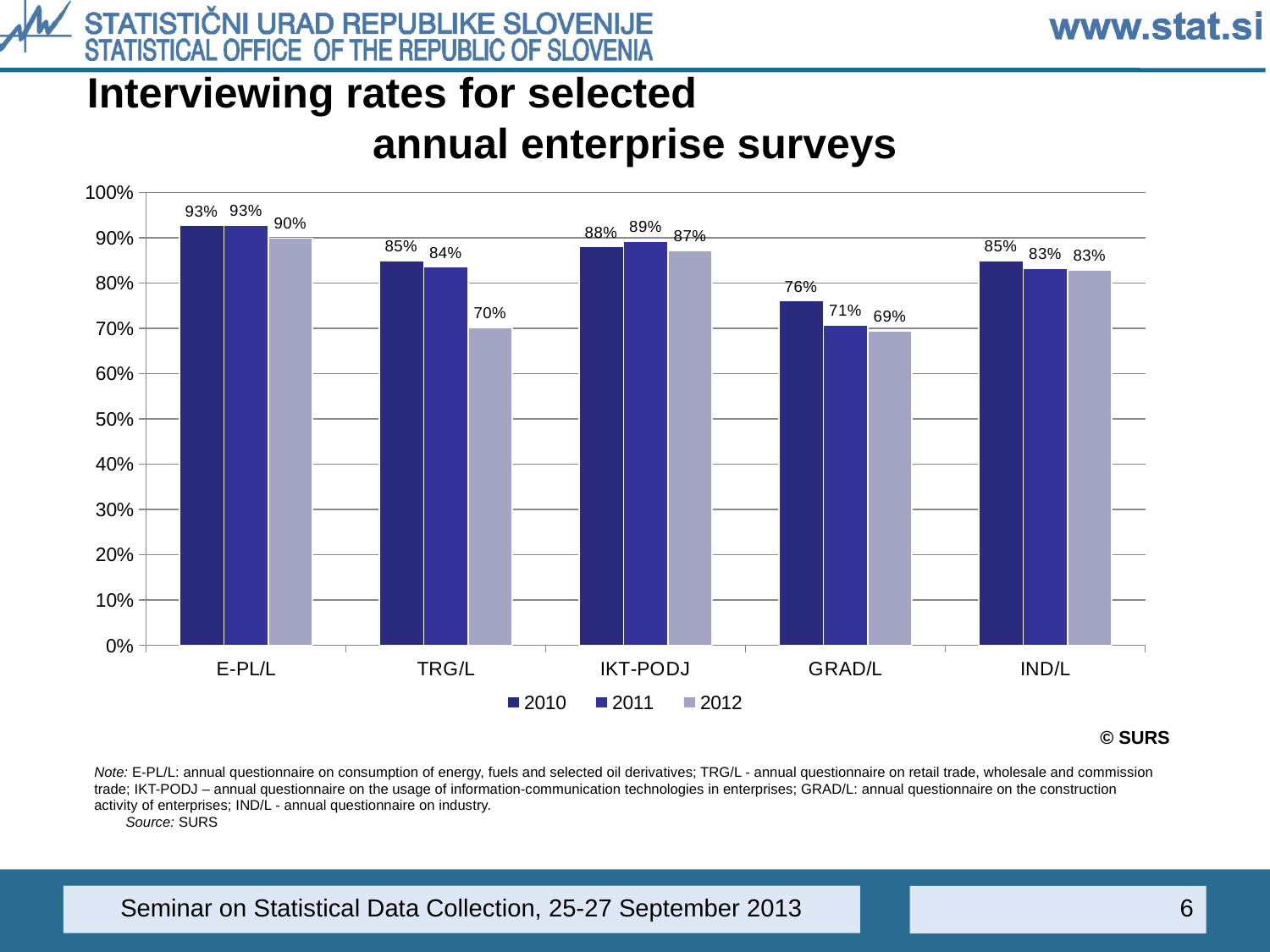
Which survey has the lowest interviewing rate in 2012? GRAD/L What is the difference between the 2010 and 2012 interviewing rates for TRG/L? 15% What is the interviewing rate for GRAD/L in 2010? 76% How many series does the legend list? 3 What is the interviewing rate for IKT-PODJ in 2011? 89% What kind of chart is shown on the slide? Bar chart Which years are listed in the chart legend? 2010, 2011, 2012 Do the interviewing rates for GRAD/L rise or fall from 2010 to 2012? Fall How many surveys are shown on the x axis? 5 What is the interviewing rate for TRG/L in 2012? 70% Which is larger, the 2011 interviewing rate for IKT-PODJ or the 2011 rate for IND/L? IKT-PODJ Which survey has the highest interviewing rate in 2010? E-PL/L